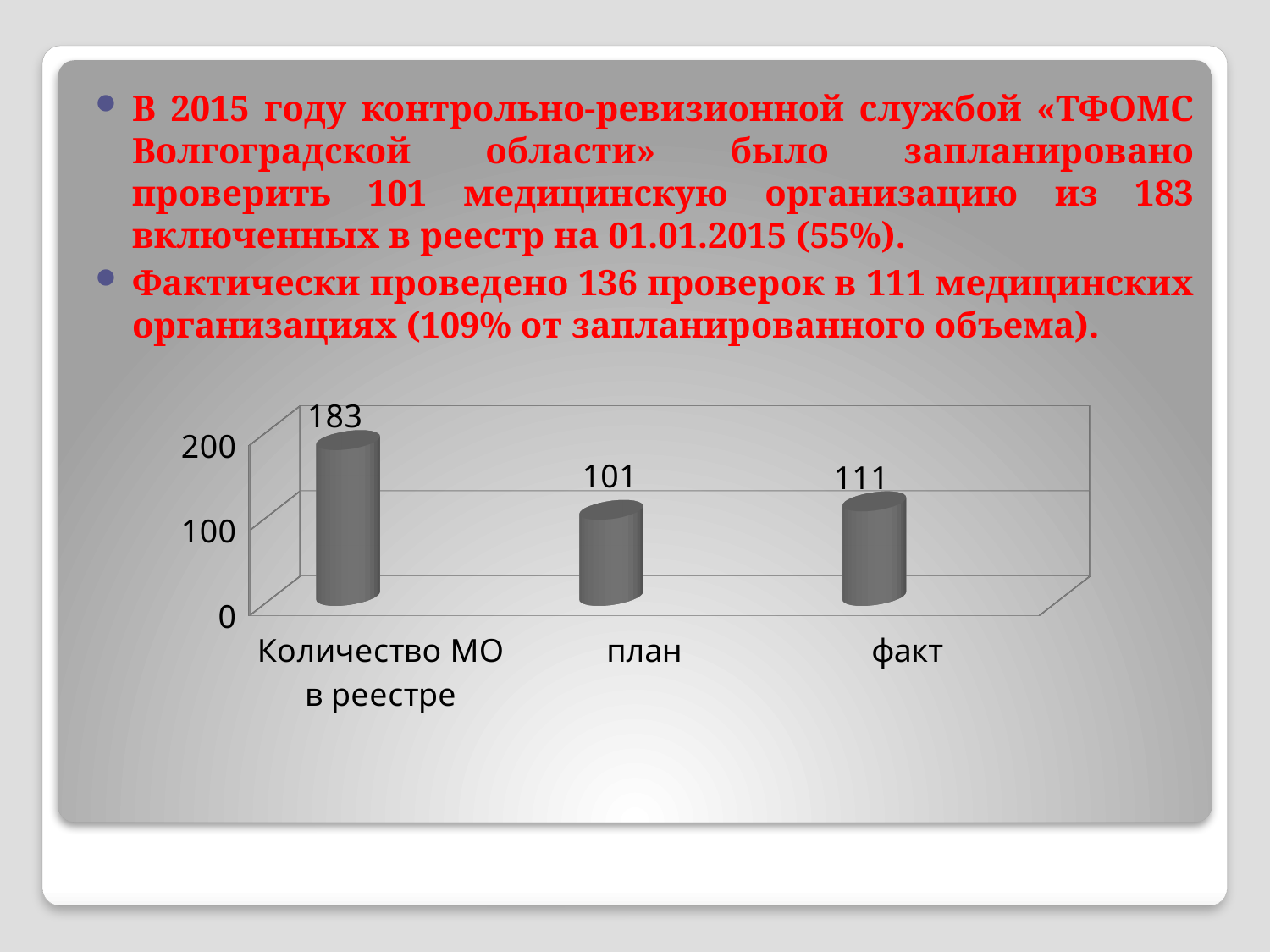
What is the difference between "Количество МО в реестре" and "план"? 82 How many categories are shown on the chart? 3 What is the value for "план"? 101 Which category has the lowest value? план Which is larger, "факт" or "план"? факт Which category has the highest value? Количество МО в реестре What is the value for "факт"? 111 What is the highest tick value shown on the vertical axis? 200 What is the difference between "факт" and "план"? 10 What kind of chart is shown on the slide? bar chart Is the value for "Количество МО в реестре" greater or less than 100? greater What is the value for "Количество МО в реестре"? 183